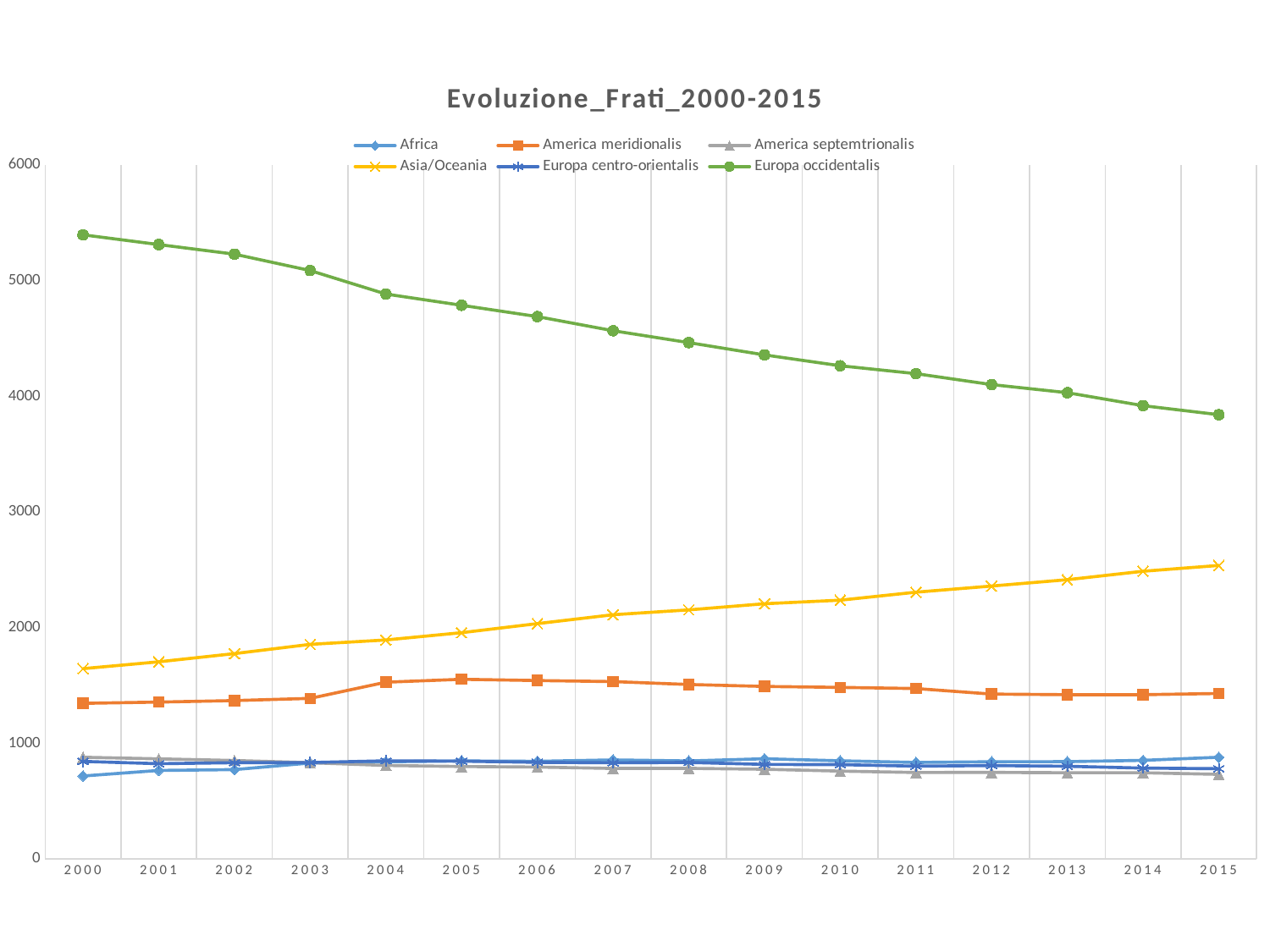
In 2015, which is larger: Asia/Oceania or America meridionalis? Asia/Oceania What is the title of the chart? Evoluzione_Frati_2000-2015 How many years are plotted along the x axis? 16 Is the value for Asia/Oceania in 2015 greater or less than 2000? greater How many series does the legend list? 6 Does the Asia/Oceania series rise or fall from 2000 to 2015? rise Is the value for Europa occidentalis in 2015 greater or less than 4000? less What kind of chart is shown on the slide? line chart Which series has the highest value in 2000? Europa occidentalis Which series has the lowest value in 2000? Africa Does the Europa occidentalis series rise or fall from 2000 to 2015? fall Is the value for Europa occidentalis in 2000 greater or less than 5000? greater